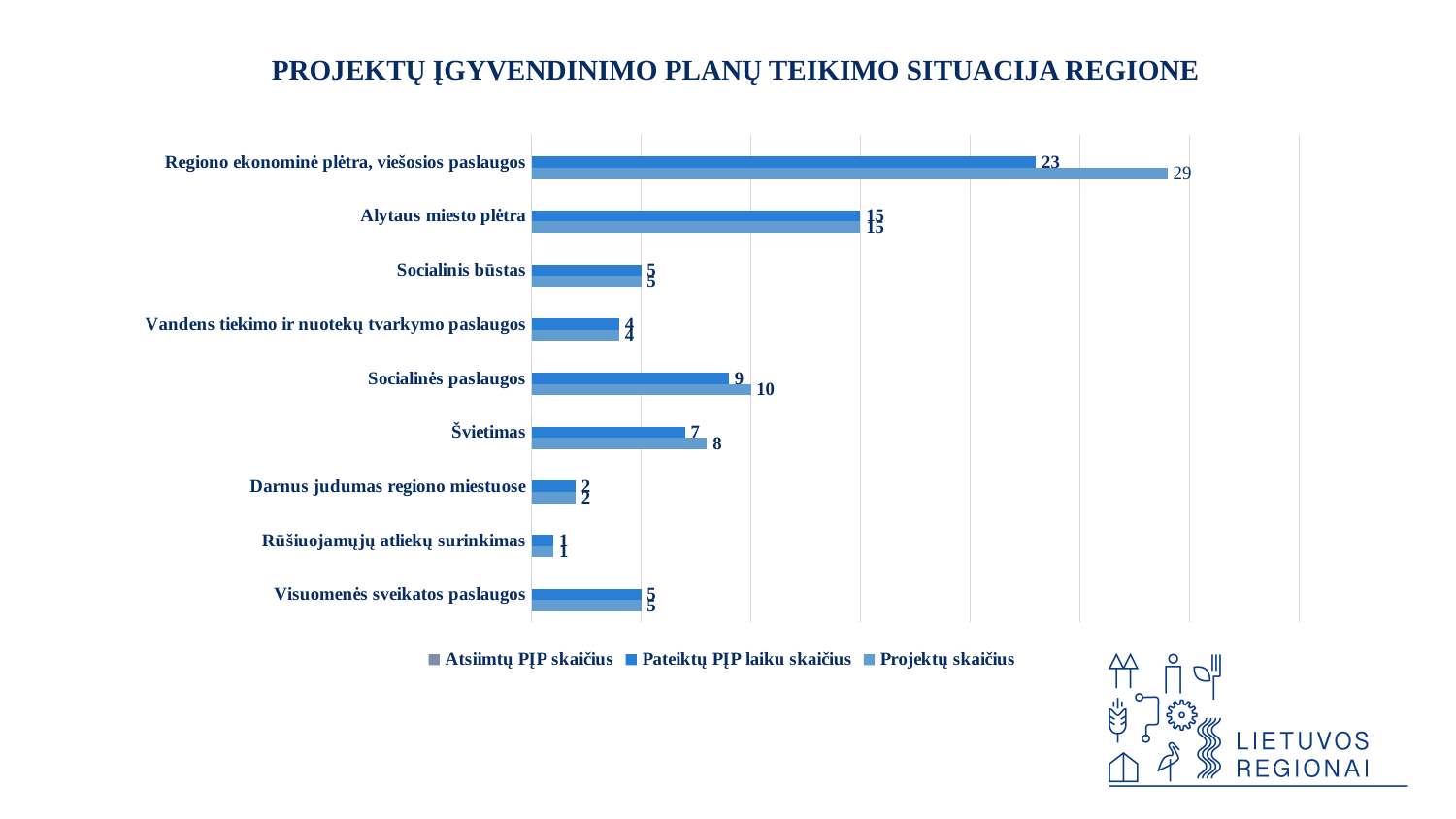
What is the difference between the Projektų skaičius and Pateiktų PĮP laiku skaičius values for Regiono ekonominė plėtra, viešosios paslaugos? 6 Which is larger for Švietimas: the Projektų skaičius value or the Pateiktų PĮP laiku skaičius value? Projektų skaičius Which category has the highest Projektų skaičius value? Regiono ekonominė plėtra, viešosios paslaugos What is the Projektų skaičius value for Socialinės paslaugos? 10 What kind of chart is shown on the slide? bar chart Which category has the lowest Projektų skaičius value? Rūšiuojamųjų atliekų surinkimas What is the Pateiktų PĮP laiku skaičius value for Švietimas? 7 How many categories are shown on the chart? 9 What is the title of the chart? PROJEKTŲ ĮGYVENDINIMO PLANŲ TEIKIMO SITUACIJA REGIONE How many series does the legend list? 3 What is the Projektų skaičius value for Regiono ekonominė plėtra, viešosios paslaugos? 29 What is the Pateiktų PĮP laiku skaičius value for Regiono ekonominė plėtra, viešosios paslaugos? 23